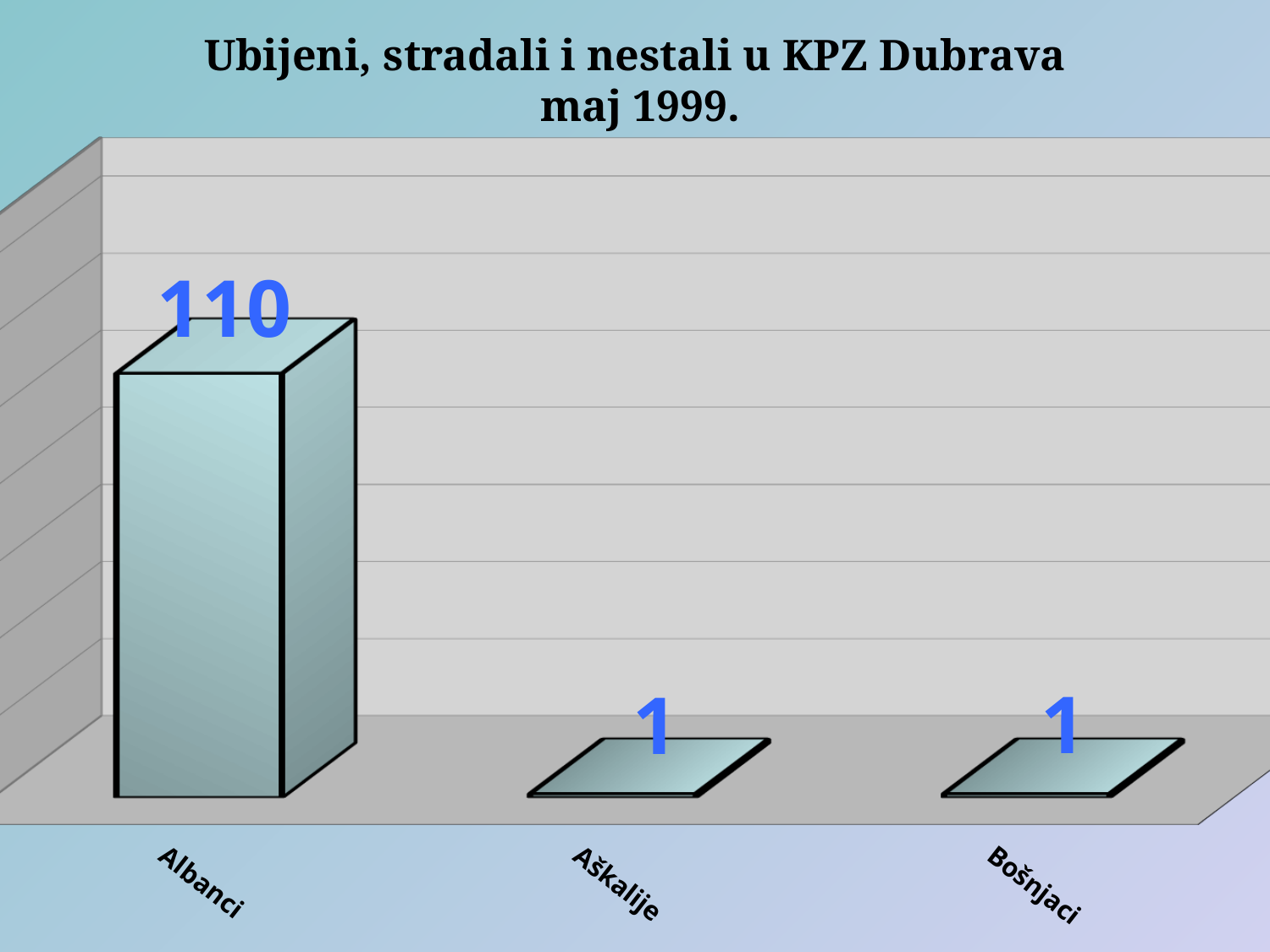
What is the difference between the values for Albanci and Aškalije? 109 What is the total of the values for Albanci, Aškalije and Bošnjaci? 112 What is the title of the chart? Ubijeni, stradali i nestali u KPZ Dubrava maj 1999. What is the value for Bošnjaci? 1 What is the value for Albanci? 110 What kind of chart is shown on the slide? bar chart What is the value for Aškalije? 1 Which is larger, the value for Albanci or the value for Bošnjaci? Albanci Which category has the highest value? Albanci How many categories are shown in the chart? 3 Do the values rise or fall from Albanci to Aškalije? fall